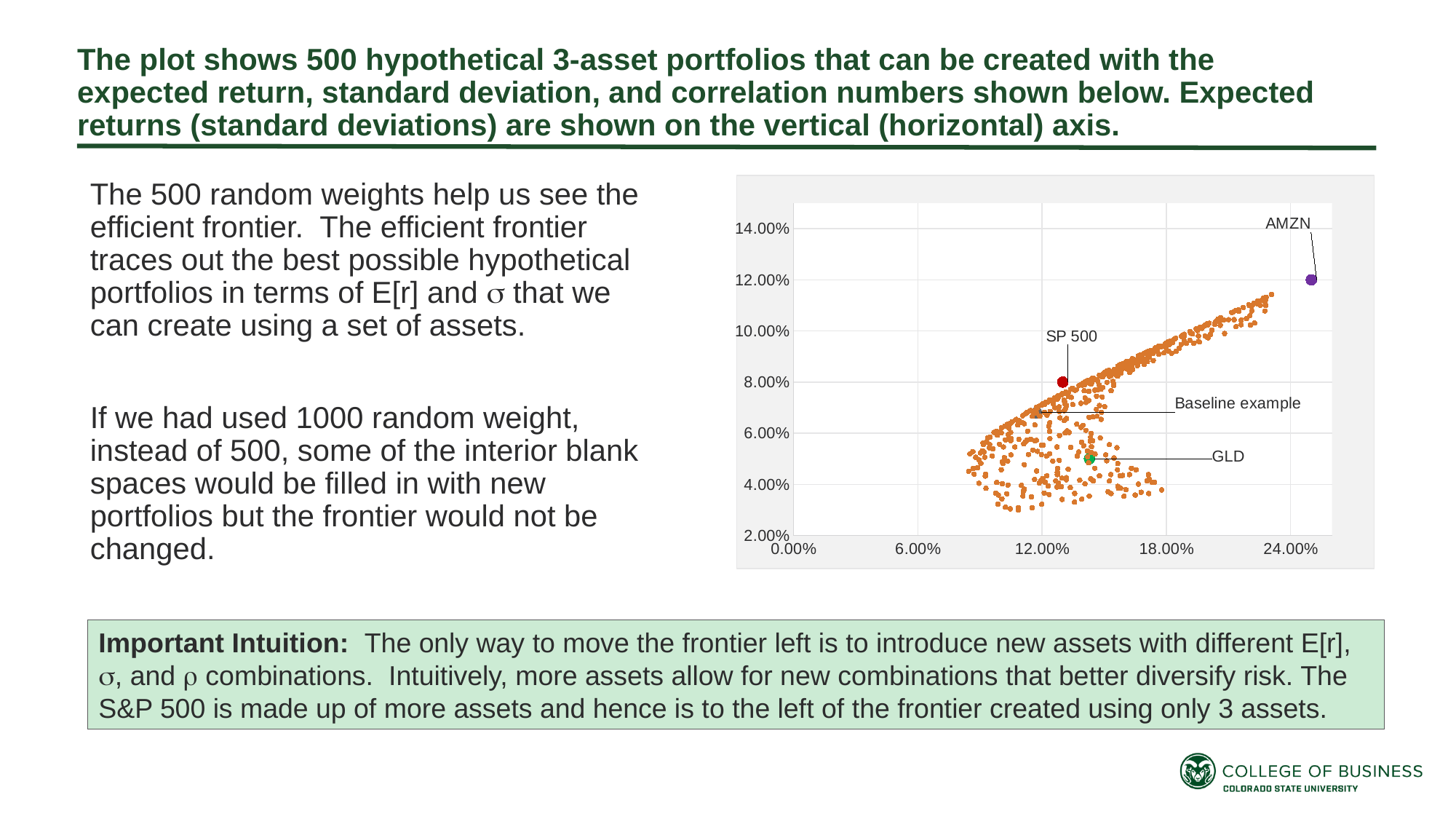
Is the standard deviation (horizontal axis) for AMZN greater or less than 24.00%? greater How many individually labeled points are marked on the chart? 4 What kind of chart is shown on the slide? scatter plot What is the highest tick value shown on the vertical axis of the chart? 14.00% What is the highest tick value shown on the horizontal axis of the chart? 24.00% Which has the larger standard deviation, AMZN or SP 500? AMZN Is the expected return (vertical axis) for GLD greater or less than 6.00%? less Which labeled point on the chart has the lowest expected return (vertical axis)? GLD Is the standard deviation (horizontal axis) for the Baseline example greater or less than 18.00%? less Which has the higher expected return, SP 500 or GLD? SP 500 Which labeled point on the chart has the highest expected return (vertical axis)? AMZN